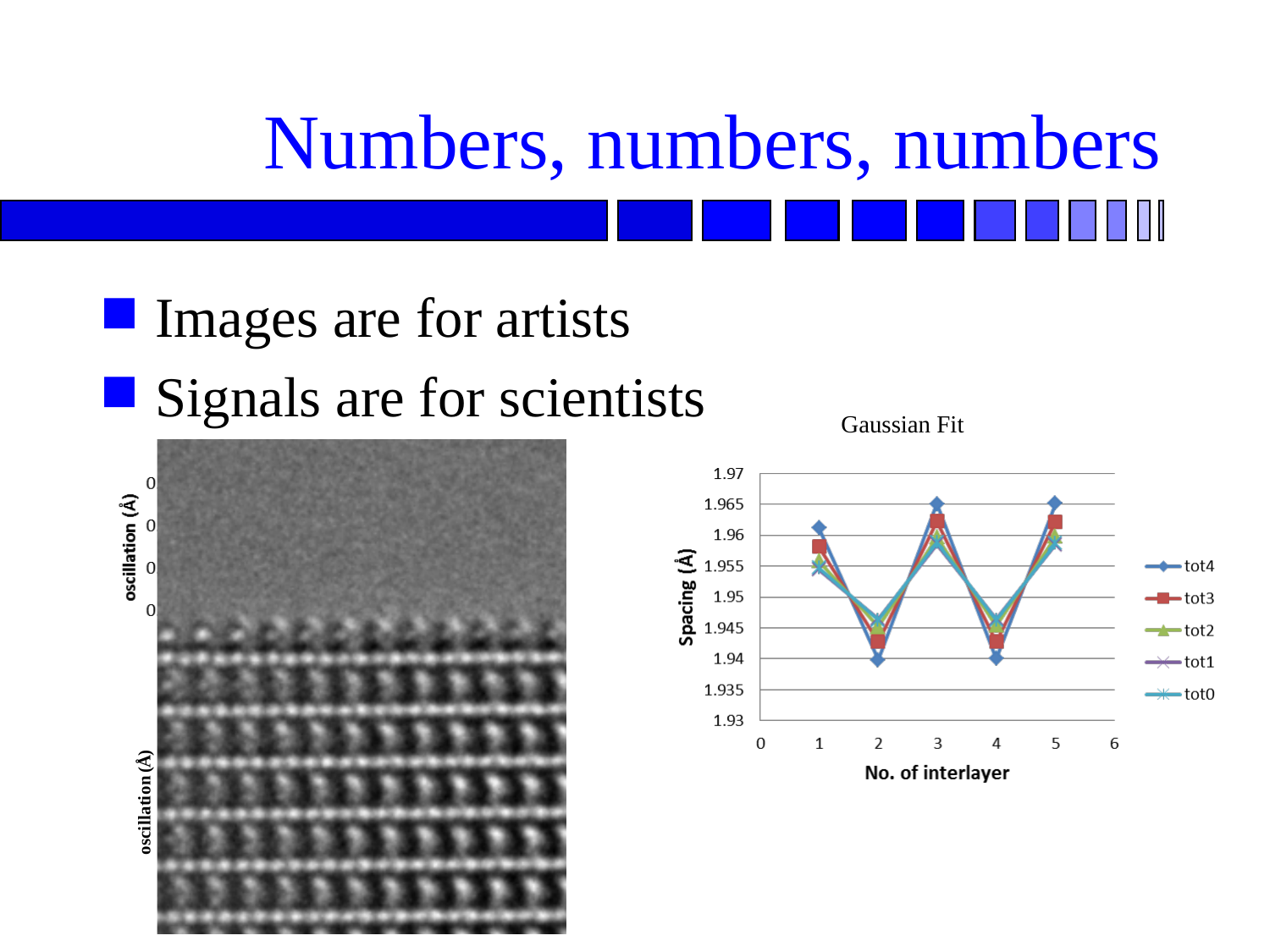
In the Gaussian Fit chart, is the value of tot4 at interlayer 2 greater or less than 1.945? less What kind of chart is the Gaussian Fit chart? line chart In the Gaussian Fit chart, is the value of tot4 at interlayer 3 greater or less than 1.96? greater In the Gaussian Fit chart, which series has the lowest value at interlayer 2? tot4 In the Gaussian Fit chart, is the tot4 value larger at interlayer 3 or at interlayer 2? interlayer 3 How many series does the legend of the Gaussian Fit chart list? 5 In the Gaussian Fit chart, do the series values rise or fall from interlayer 1 to interlayer 2? fall What is the x-axis label of the Gaussian Fit chart? No. of interlayer How many data points does each series in the Gaussian Fit chart have? 5 In the Gaussian Fit chart, is the value of tot3 at interlayer 1 greater or less than 1.955? greater In the Gaussian Fit chart, which series has the highest value at interlayer 3? tot4